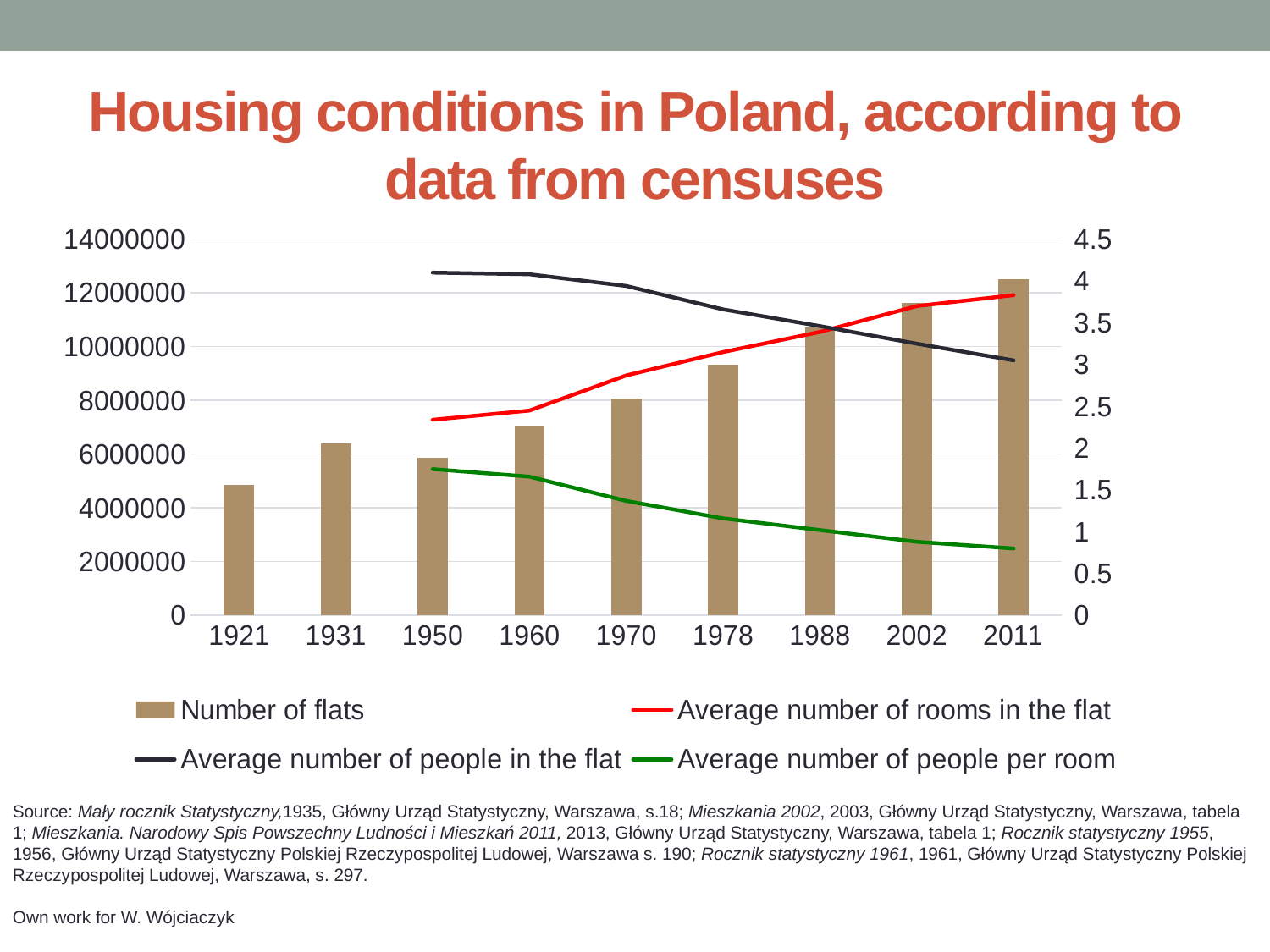
In which year is the number of flats highest? 2011 Is the number of flats in 1921 greater or less than 6000000? less Is the number of flats in 2011 greater or less than 12000000? greater How many census years are shown on the x axis? 9 What kind of chart is shown on the slide? A combined bar and line chart How many series does the legend list? 4 Which series is drawn as a green line? Average number of people per room In which year is the number of flats lowest? 1921 Does the average number of rooms in the flat rise or fall from 1950 to 2011? rise Is the average number of people per room in 2011 greater or less than 1? less Which year has more flats, 1931 or 1950? 1931 Does the average number of people in the flat rise or fall from 1950 to 2011? fall